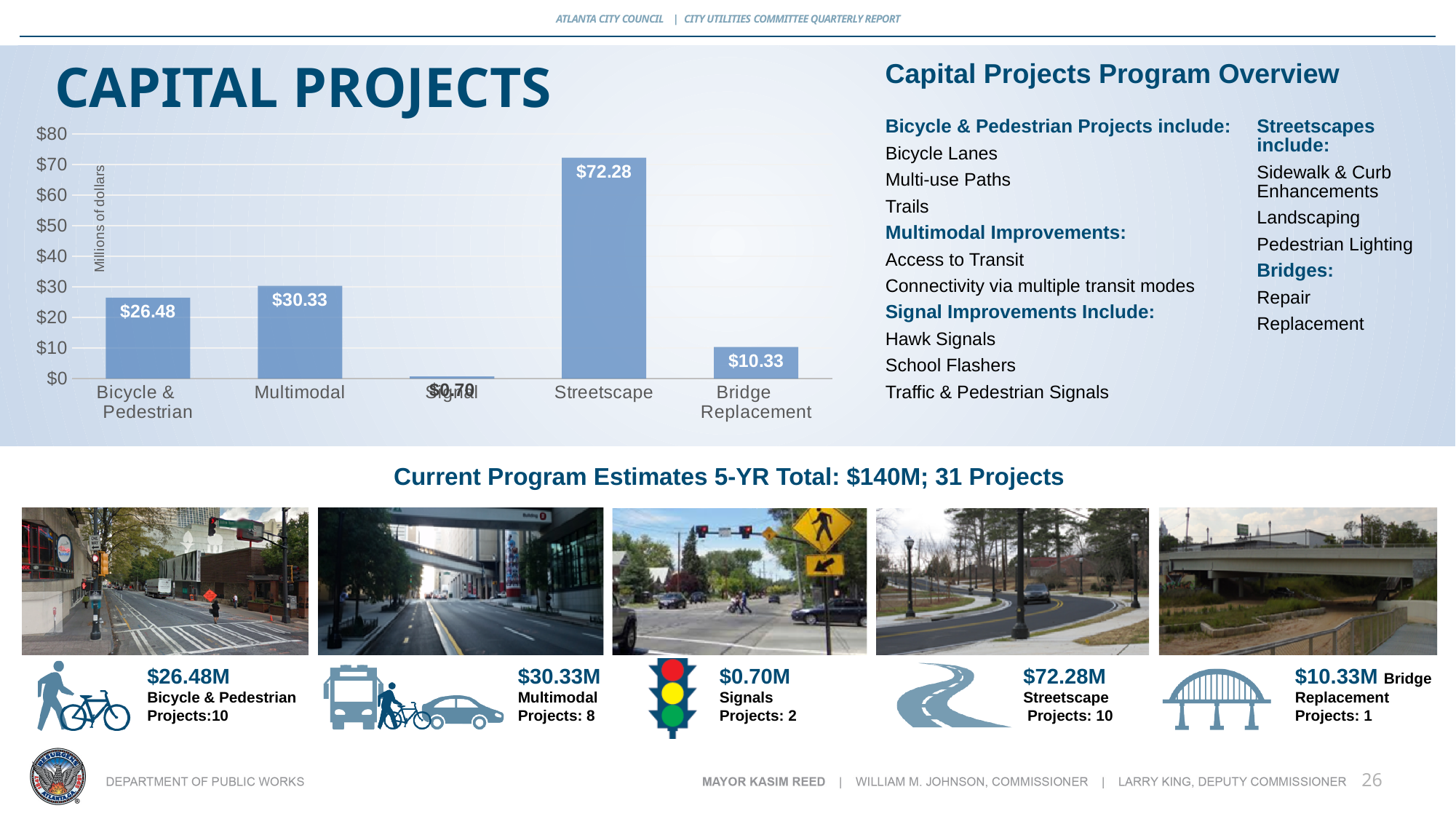
What is the value for Bridge Replacement in the Capital Projects chart? $10.33 What is the value for Bicycle & Pedestrian in the Capital Projects chart? $26.48 How many categories are shown in the Capital Projects chart? 5 What kind of chart is the Capital Projects chart? bar chart Which category has the highest value in the Capital Projects chart? Streetscape What is the label on the vertical axis of the Capital Projects chart? Millions of dollars What is the value for Multimodal in the Capital Projects chart? $30.33 What is the value for Streetscape in the Capital Projects chart? $72.28 Which is larger in the Capital Projects chart, Multimodal or Bicycle & Pedestrian? Multimodal What is the difference between the Streetscape and Multimodal values in the Capital Projects chart? $41.95 Which category has the lowest value in the Capital Projects chart? Signal Is the value for Streetscape in the Capital Projects chart greater or less than $60? greater